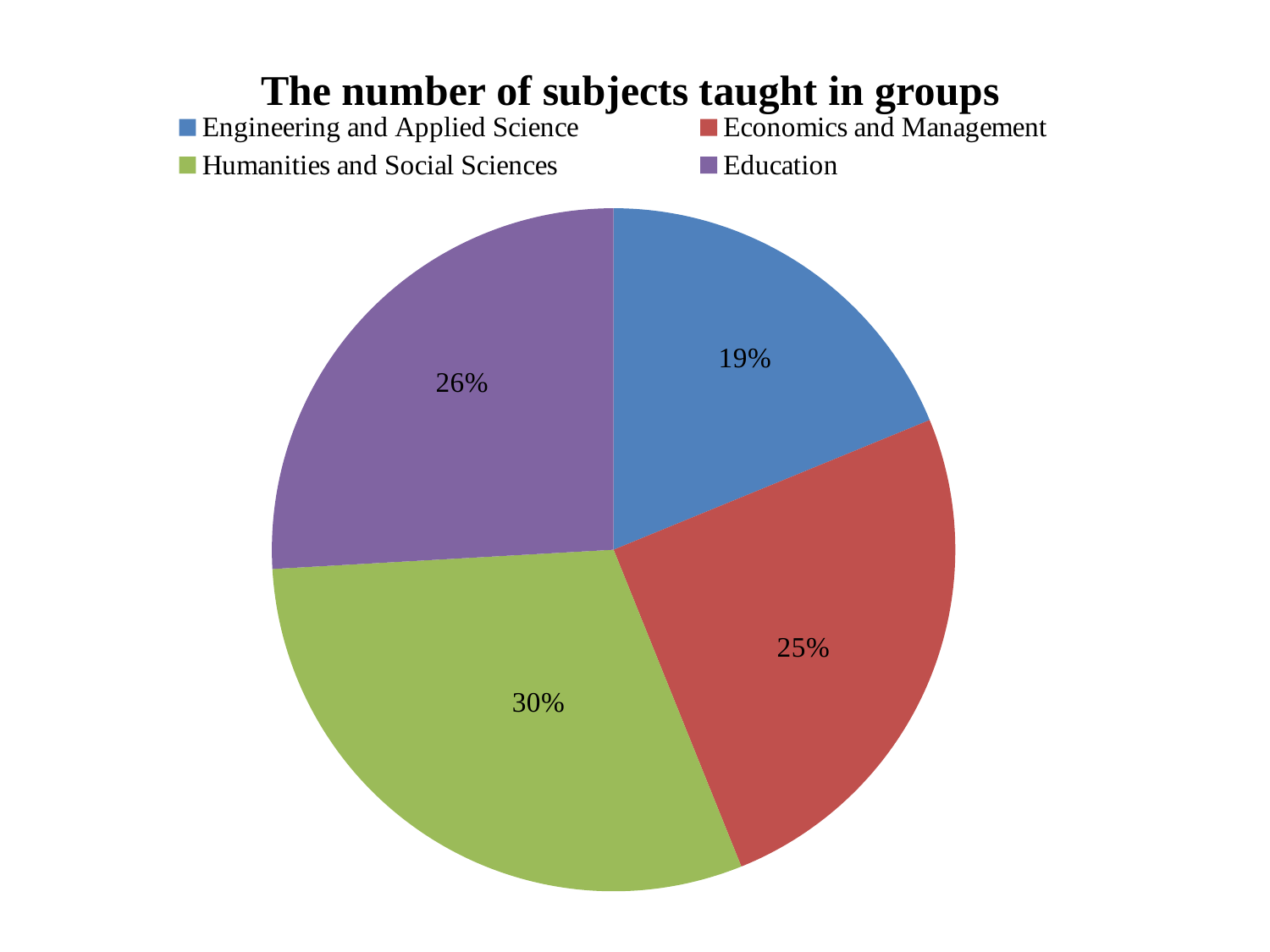
What share of the pie does Economics and Management have? 25% What is the title of the chart? The number of subjects taught in groups What share of the pie does Engineering and Applied Science have? 19% What share of the pie does Humanities and Social Sciences have? 30% What colour is the slice for Humanities and Social Sciences? green How many categories are shown in the pie chart? 4 Which category has the largest slice of the pie? Humanities and Social Sciences What is the difference in percentage points between Humanities and Social Sciences and Engineering and Applied Science? 11 Which category has the smallest slice of the pie? Engineering and Applied Science Which is larger, the share for Education or the share for Economics and Management? Education What kind of chart is shown on the slide? pie chart